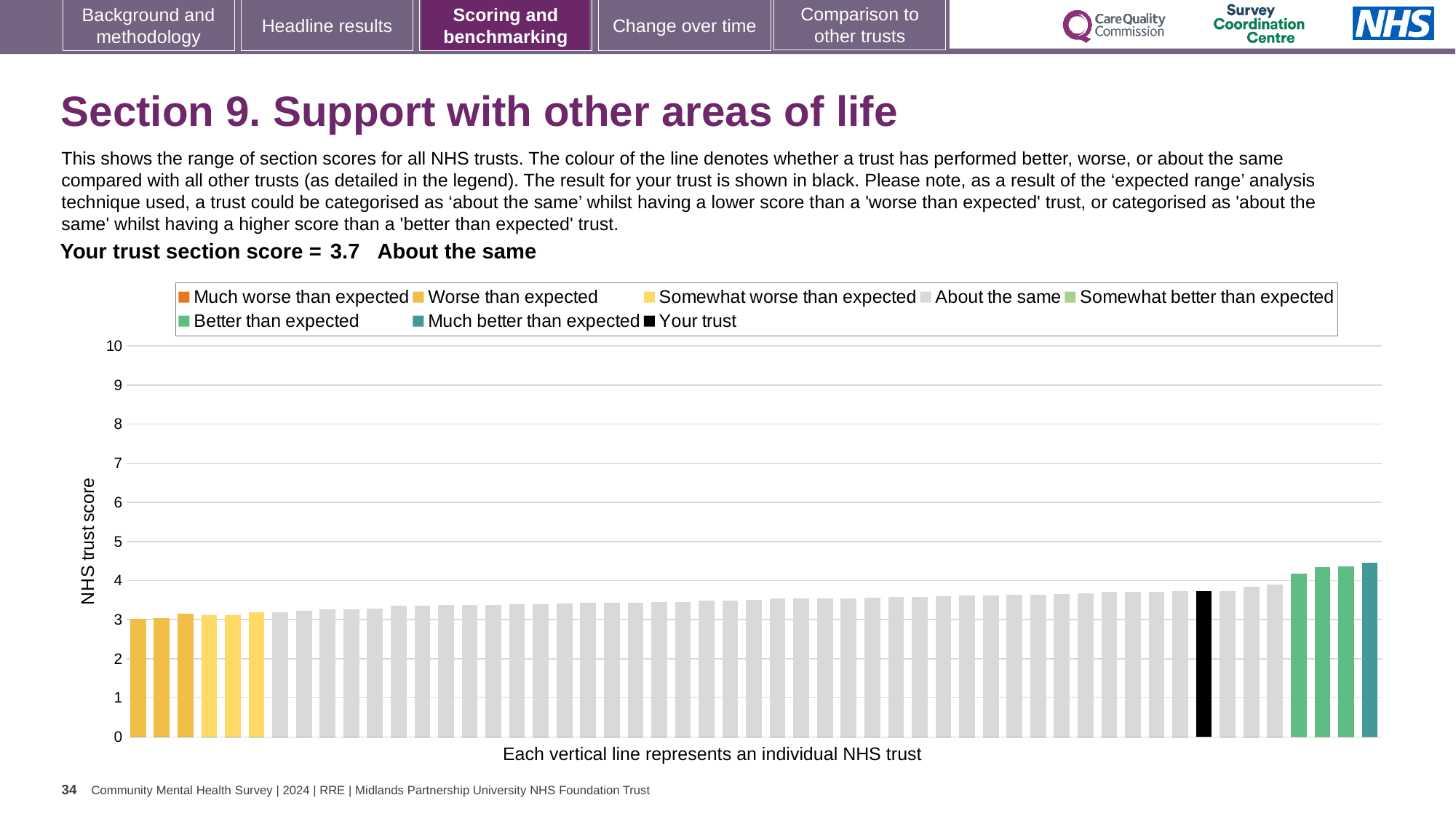
What kind of chart is shown on the slide? bar chart Which legend category does the tallest bar belong to? Much better than expected Is the value of the lowest bar greater or less than 2? greater Which legend category does the lowest bar belong to? Worse than expected What is the label on the vertical axis of the chart? NHS trust score Do the bar values rise or fall from left to right along the x axis? rise Is the value for your trust greater or less than 4? less Which legend category is your trust's section score classified as? About the same What is the section score for your trust? 3.7 Is the value of the tallest bar greater or less than 4? greater Is your trust's bar higher or lower than the tallest bar on the chart? lower How many entries does the chart legend list? 8